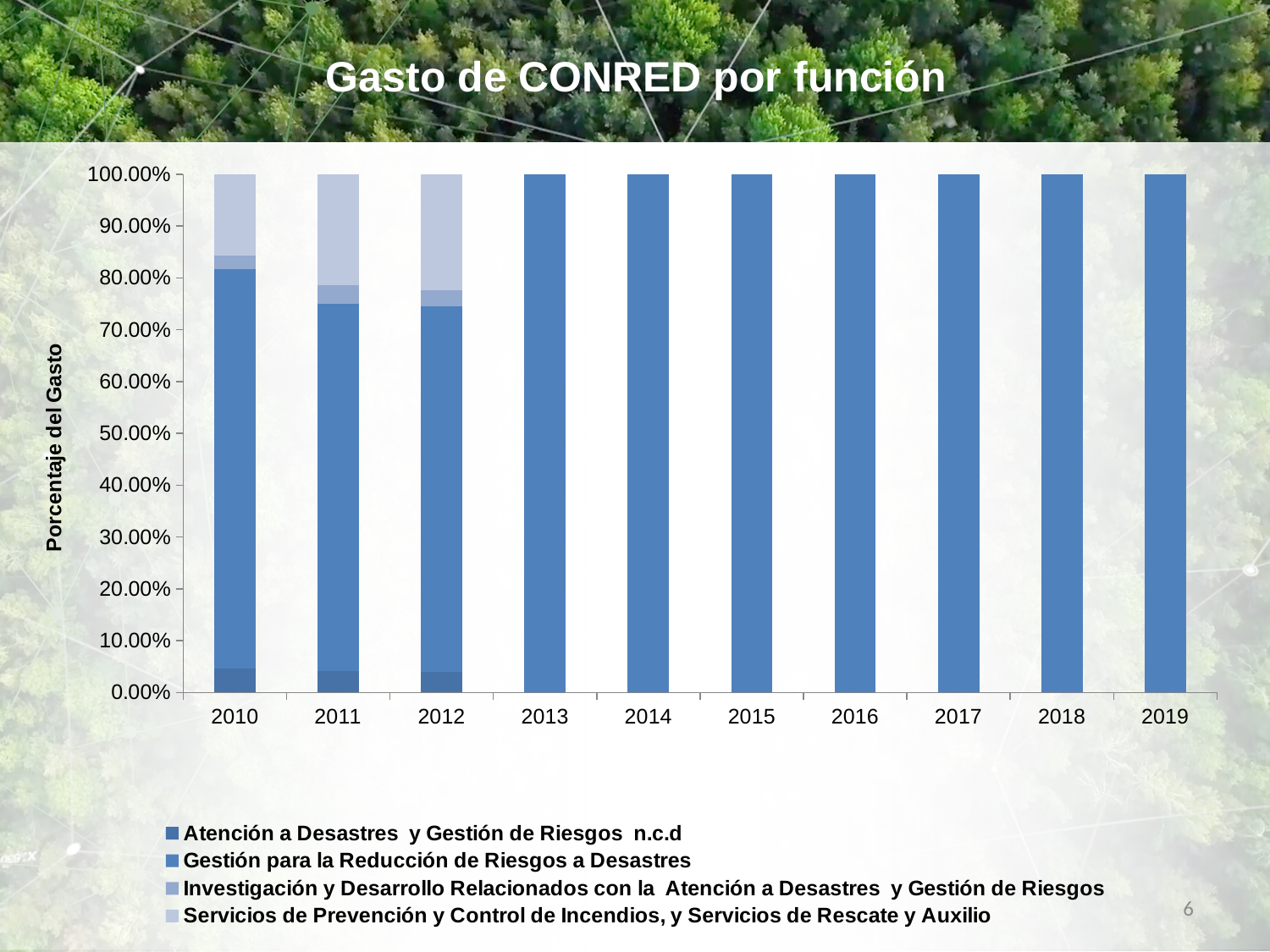
Is the value for Gestión para la Reducción de Riesgos a Desastres in 2010 greater or less than 70.00%? greater Is the value for Servicios de Prevención y Control de Incendios, y Servicios de Rescate y Auxilio in 2011 greater or less than 30.00%? less In how many years does the stacked bar contain more than one segment? 3 Is the Servicios de Prevención y Control de Incendios, y Servicios de Rescate y Auxilio segment larger in 2010 or in 2011? 2011 Is the value for Atención a Desastres y Gestión de Riesgos n.c.d in 2010 greater or less than 10.00%? less What kind of chart is shown on the slide? Stacked bar chart How many series does the chart legend list? 4 Which is the first year in which the bar consists of a single segment? 2013 What is the label on the vertical axis of the chart? Porcentaje del Gasto What is the title of the chart? Gasto de CONRED por función What is the total of the stacked bar for 2015? 100.00% How many years are shown on the x axis of the chart? 10